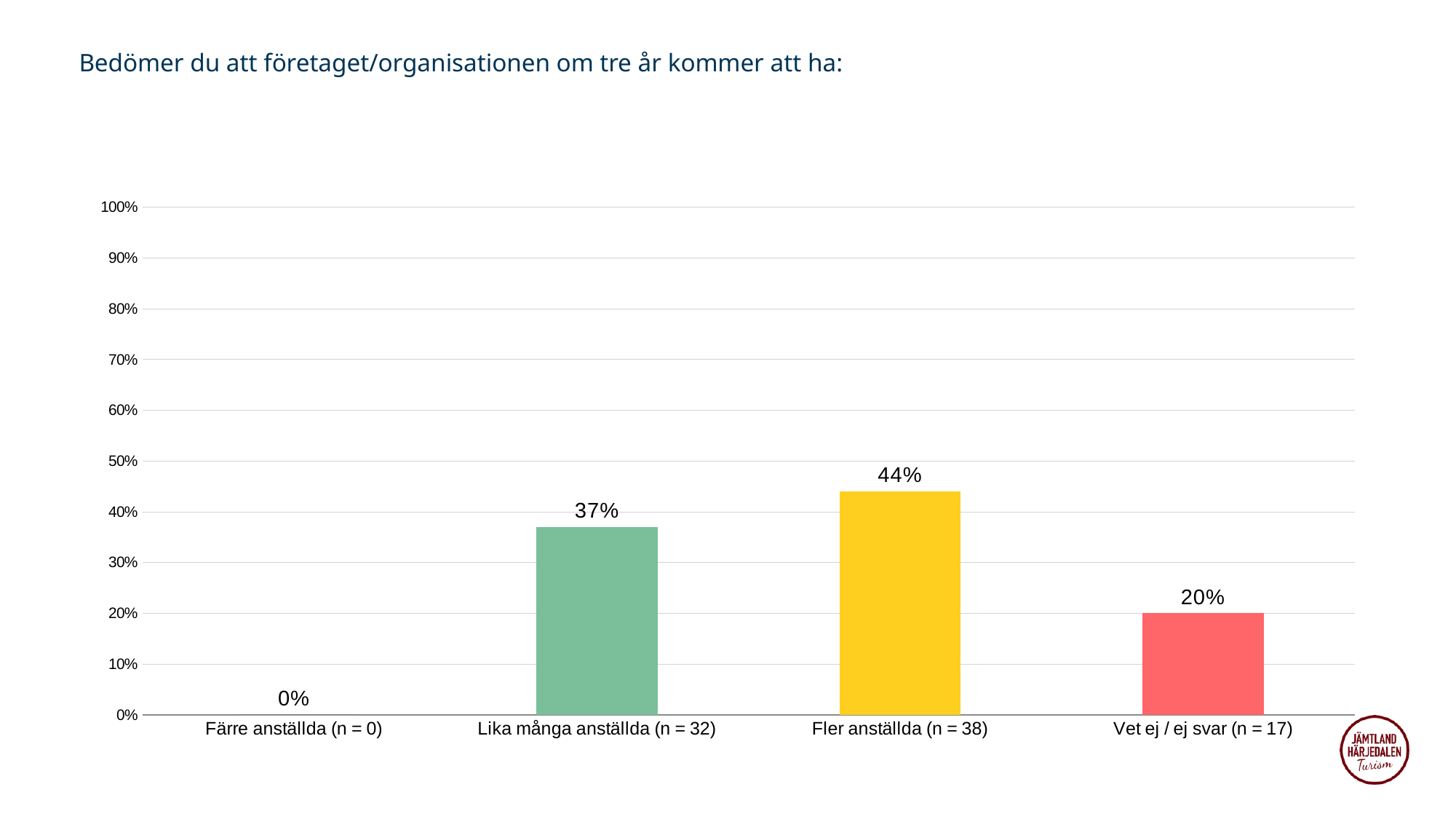
What is the value for "Färre anställda (n = 0)"? 0% What is the value for "Lika många anställda (n = 32)"? 37% How many categories are shown on the x axis? 4 Which is larger, the value for "Lika många anställda (n = 32)" or the value for "Vet ej / ej svar (n = 17)"? Lika många anställda (n = 32) What is the value for "Fler anställda (n = 38)"? 44% What is the title of the chart? Bedömer du att företaget/organisationen om tre år kommer att ha: Which category has the lowest value? Färre anställda (n = 0) What is the difference between the values for "Fler anställda (n = 38)" and "Lika många anställda (n = 32)"? 7% What is the value for "Vet ej / ej svar (n = 17)"? 20% Which category has the highest value? Fler anställda (n = 38) What is the difference between the values for "Lika många anställda (n = 32)" and "Vet ej / ej svar (n = 17)"? 17% What kind of chart is shown on the slide? Bar chart